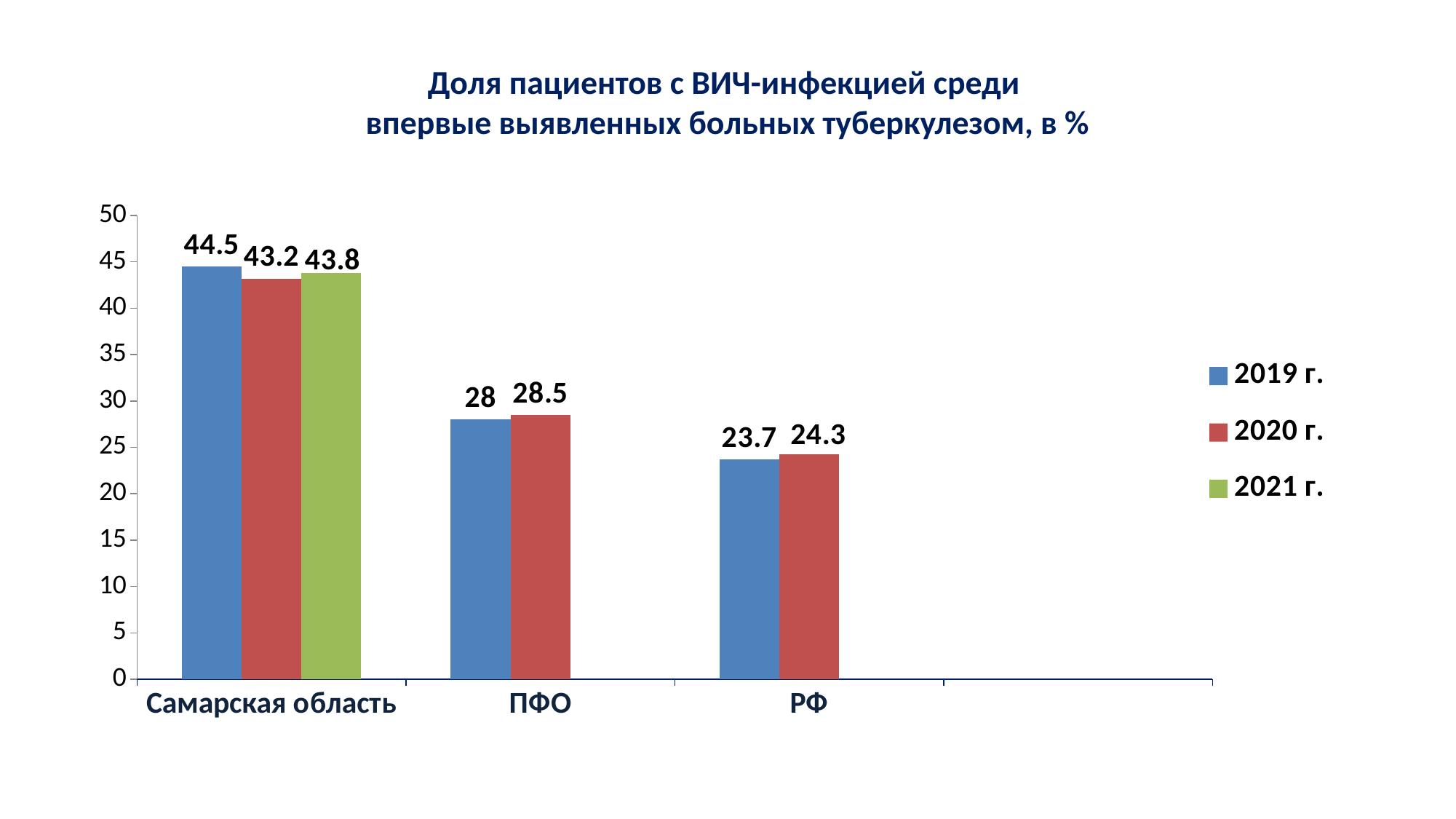
What kind of chart is shown on the slide? Bar chart Which category has the highest value in 2020 г.? Самарская область How many series does the legend list? 3 What is the difference between the 2019 г. and 2020 г. values for Самарская область? 1.3 What is the value for Самарская область in 2019 г.? 44.5 What is the value for ПФО in 2020 г.? 28.5 What is the difference between the 2020 г. values for ПФО and РФ? 4.2 What is the value for Самарская область in 2021 г.? 43.8 What is the value for РФ in 2019 г.? 23.7 Which category has the lowest value in 2019 г.? РФ Which is larger for РФ: the 2019 г. value or the 2020 г. value? 2020 г. Which category has a bar for 2021 г.? Самарская область